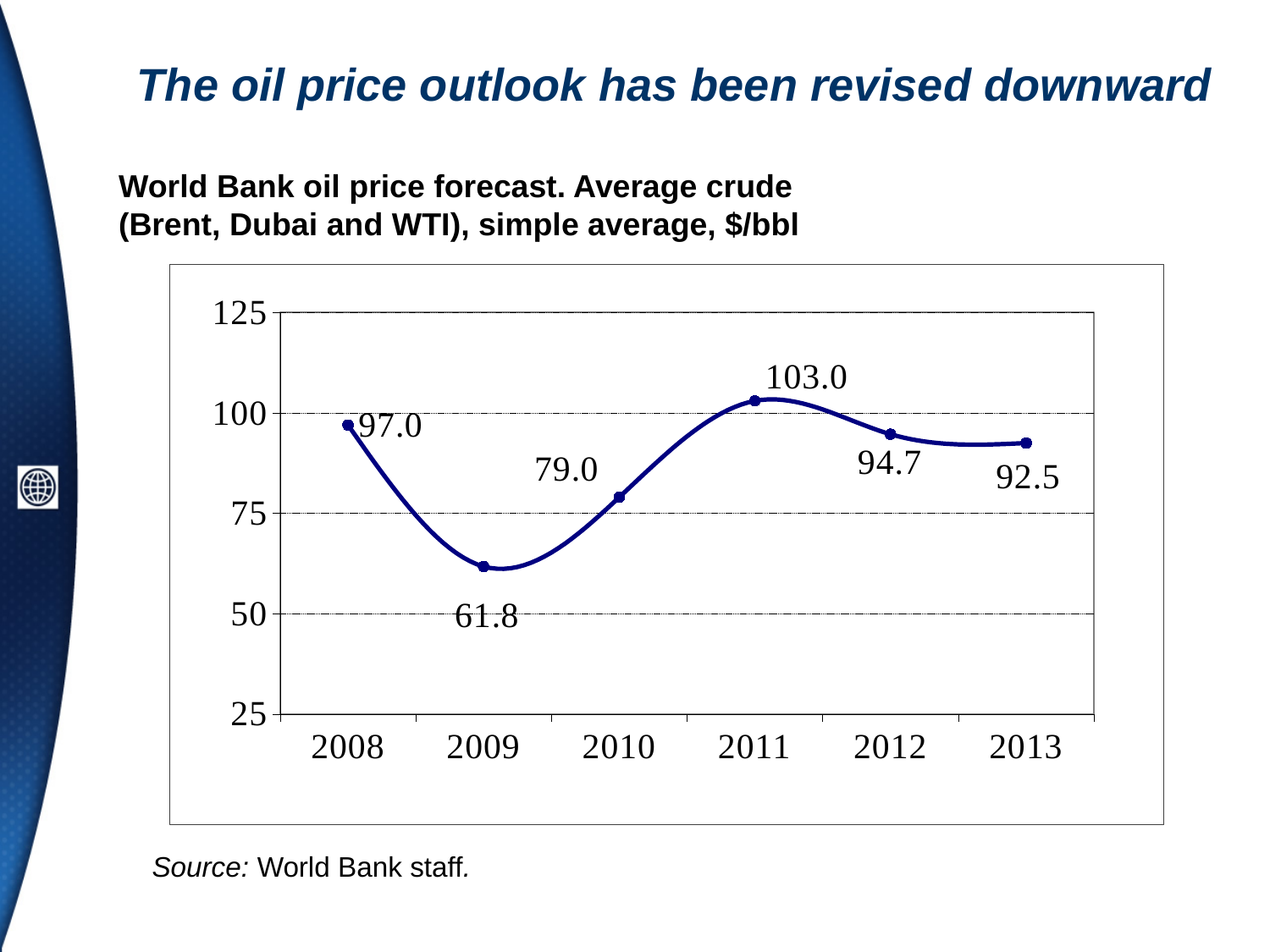
Which year has a higher forecast oil price, 2008 or 2010? 2008 Which year has the lowest forecast oil price? 2009 What kind of chart is shown on the slide? Line chart What is the forecast oil price for 2011? 103.0 How many years are plotted on the chart? 6 Does the forecast oil price rise or fall from 2011 to 2013? Fall Is the forecast oil price for 2010 greater or less than 75? greater What is the forecast oil price for 2013? 92.5 What is the forecast oil price for 2009? 61.8 What is the difference between the 2012 and 2013 forecast oil prices? 2.2 Which year has the highest forecast oil price? 2011 What is the difference between the 2011 and 2009 forecast oil prices? 41.2